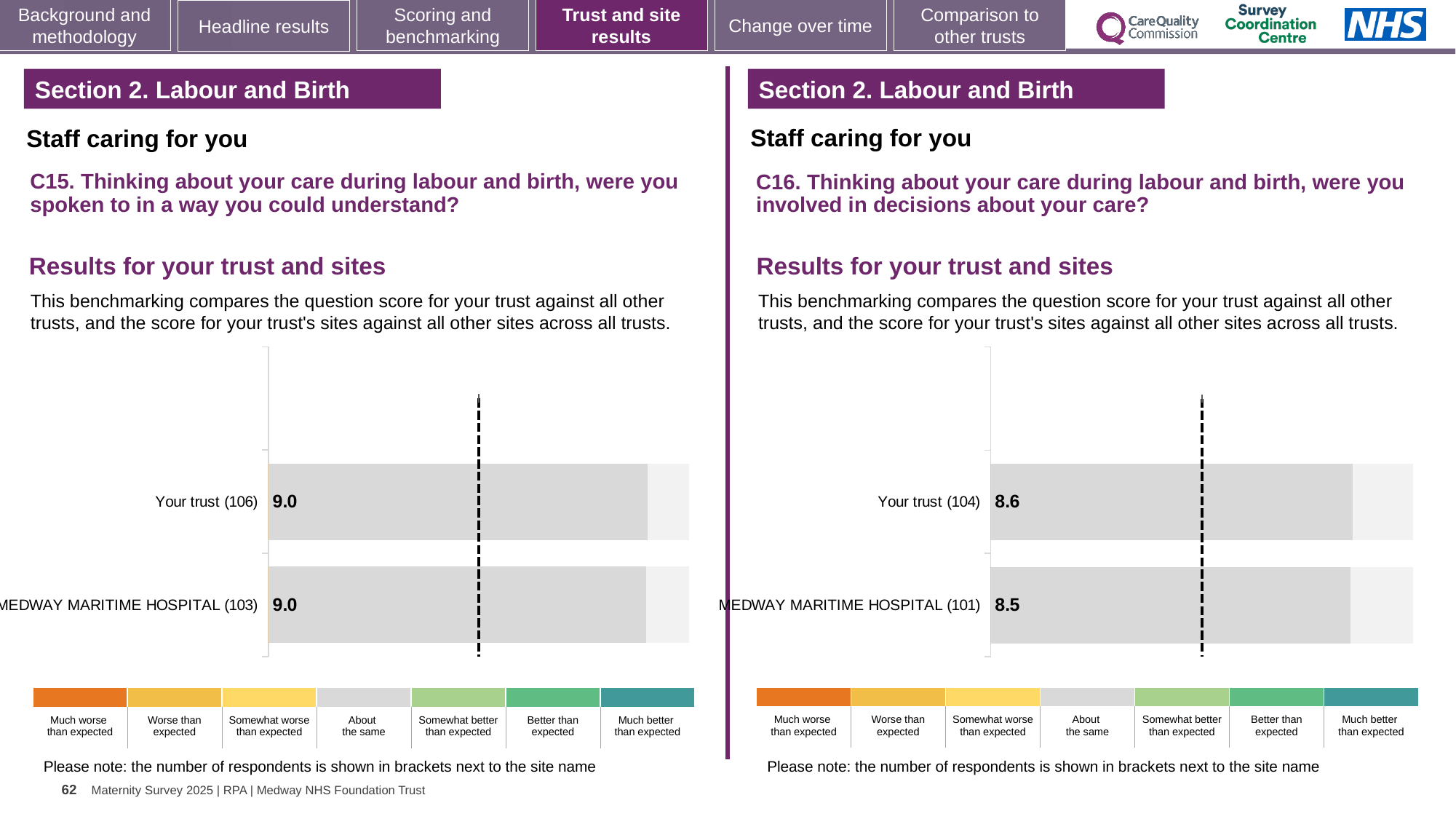
In the C16 chart on the right, what is the difference between the score for Your trust and the score for Medway Maritime Hospital? 0.1 What kind of chart is used in the C16 chart on the right? Bar chart In the C16 chart on the right, what is the score for Your trust? 8.6 In the C15 chart on the left, how many bars are plotted? 2 In the C15 chart on the left, what is the score for Medway Maritime Hospital? 9.0 In the C16 chart on the right, how many respondents are shown in brackets for Medway Maritime Hospital? 101 In the C15 chart on the left, what is the score for Your trust? 9.0 In the C15 chart on the left, how many categories does the colour key below the chart list? 7 In the C16 chart on the right, what colour is used for 'Much worse than expected' in the key below the chart? Orange In the C16 chart on the right, which has the higher score, Your trust or Medway Maritime Hospital? Your trust In the C16 chart on the right, what is the score for Medway Maritime Hospital? 8.5 In the C15 chart on the left, how many respondents are shown in brackets for Your trust? 106